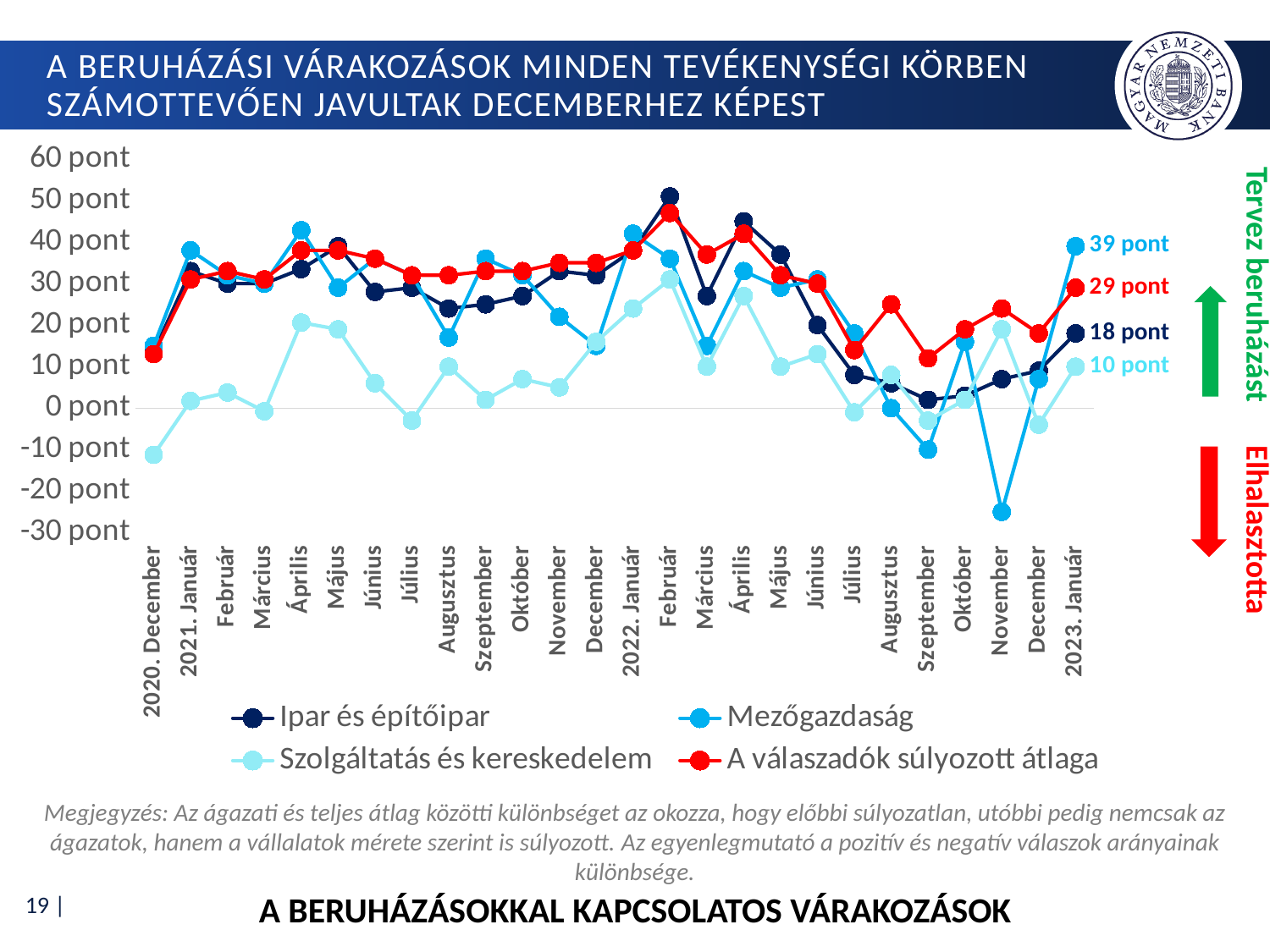
How many time points are plotted along the x axis? 26 What is the difference between the Mezőgazdaság and Ipar és építőipar values in 2023. Január? 21 pont What type of chart is shown on the slide? line chart What is the value for Ipar és építőipar in 2023. Január? 18 pont Is the value for Mezőgazdaság in 2022. November greater or less than -20 pont? less Is the value for Szolgáltatás és kereskedelem in 2020. December greater or less than 0 pont? less Which series has the lowest value in 2023. Január? Szolgáltatás és kereskedelem Which series has the highest value in 2023. Január? Mezőgazdaság How many series does the legend list? 4 What is the value for A válaszadók súlyozott átlaga in 2023. Január? 29 pont What is the value for Mezőgazdaság in 2023. Január? 39 pont What is the value for Szolgáltatás és kereskedelem in 2023. Január? 10 pont